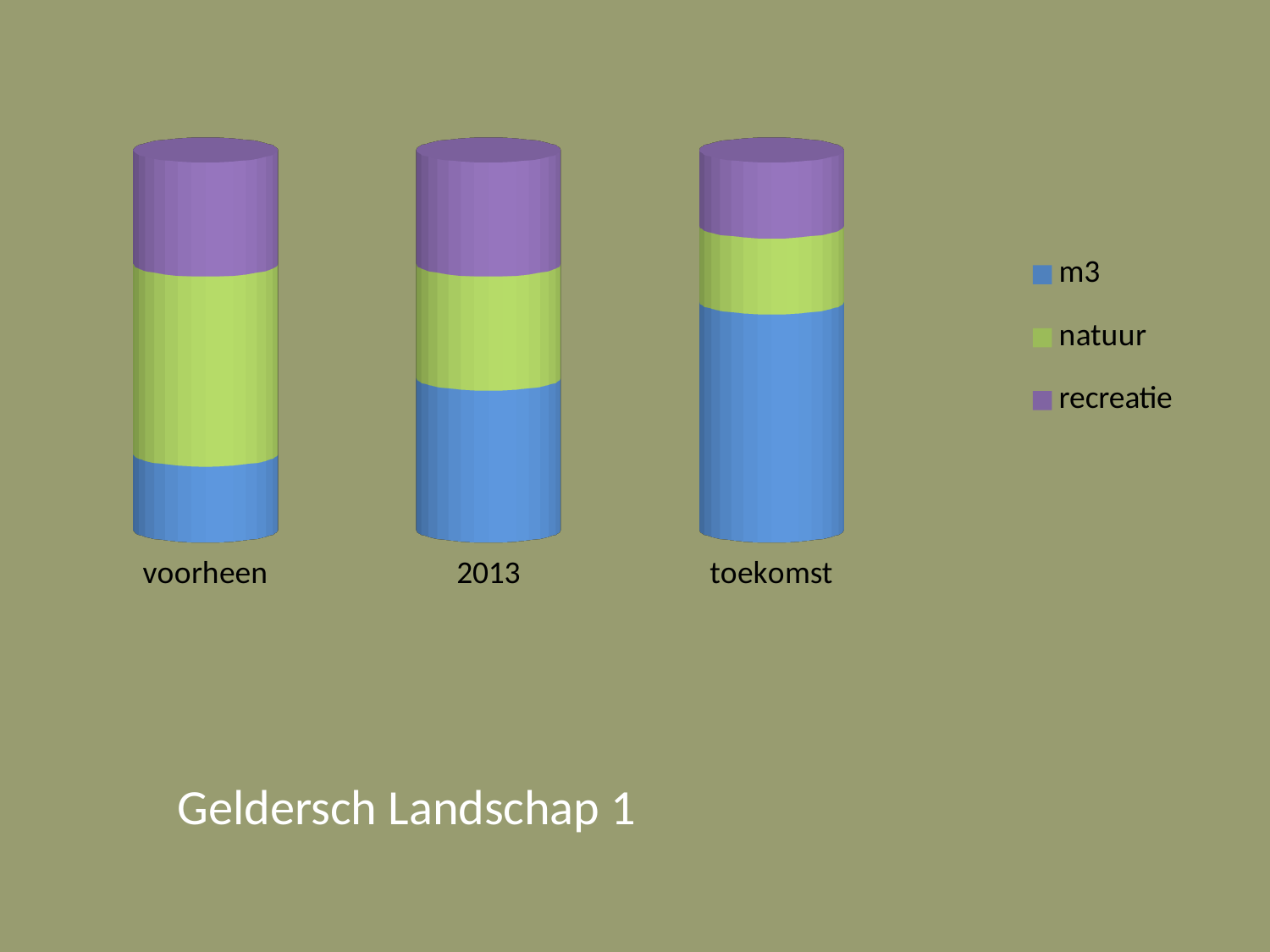
What are the series names listed in the chart's legend? m3, natuur, recreatie Does the m3 segment rise or fall from voorheen to toekomst? rise Does the natuur segment rise or fall from voorheen to toekomst? fall In which category is the m3 segment the largest? toekomst In the voorheen bar, which segment is larger: m3 or natuur? natuur What are the category labels along the x axis of the chart? voorheen, 2013, toekomst In which category is the recreatie segment the smallest? toekomst What kind of chart is shown on the slide? bar chart In which category is the natuur segment the smallest? toekomst How many categories are shown along the x axis of the chart? 3 In which category is the natuur segment the largest? voorheen How many series does the chart's legend list? 3